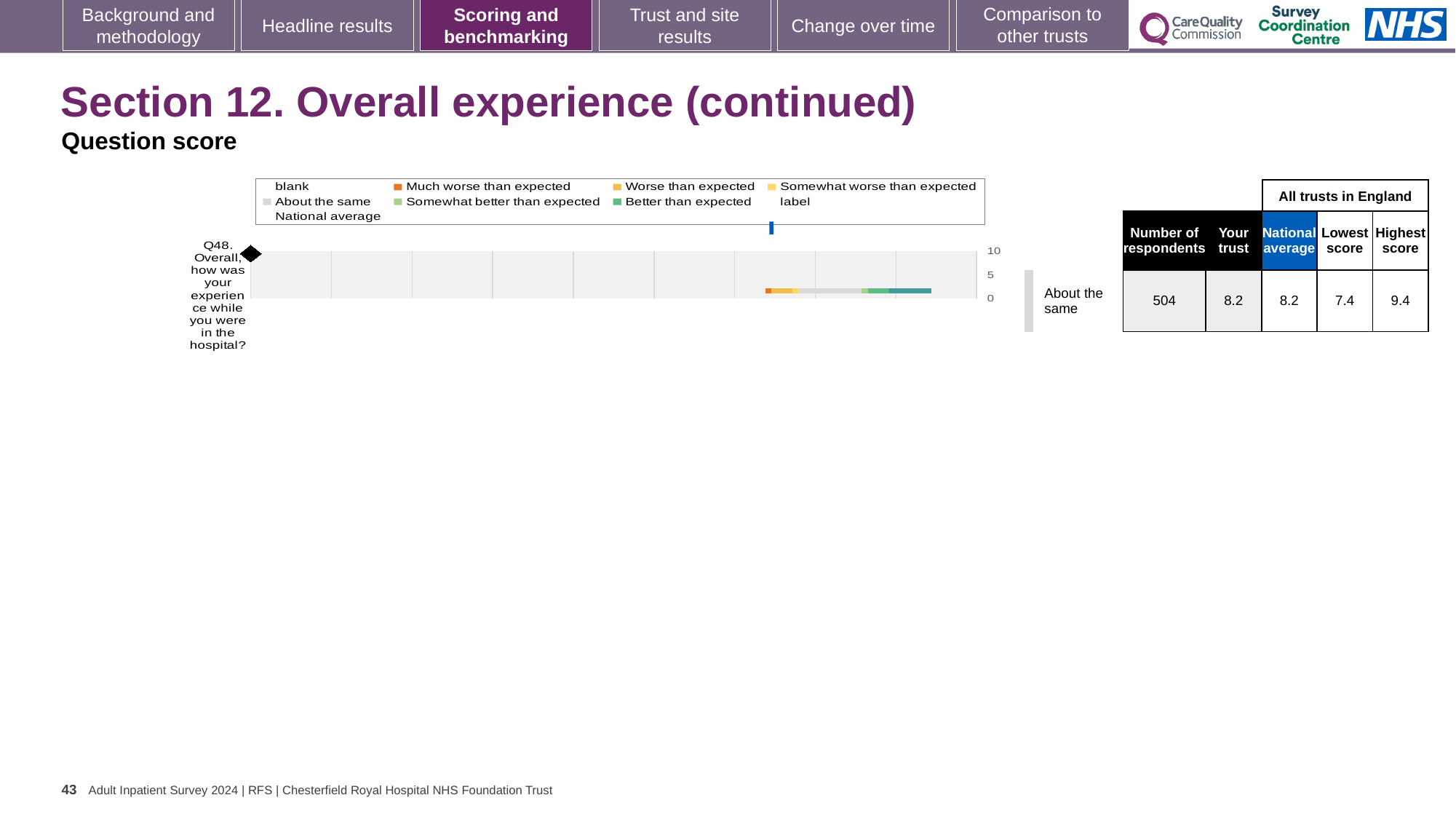
What is the highest score among all trusts in England for Q48? 9.4 What is the lowest score among all trusts in England for Q48? 7.4 What is the national average score for Q48? 8.2 What is the difference between the highest and lowest scores for Q48 across all trusts in England? 2.0 Which question is plotted on the chart? Q48. Overall, how was your experience while you were in the hospital? How many respondents answered Q48? 504 What is the maximum value shown on the chart's score axis? 10 How many survey questions are plotted on the chart? 1 What kind of chart is shown on the slide? bar chart What benchmark category is the trust's Q48 score placed in? About the same What is the 'Your trust' score for Q48? 8.2 Is the trust's score for Q48 higher or lower than the national average? the same